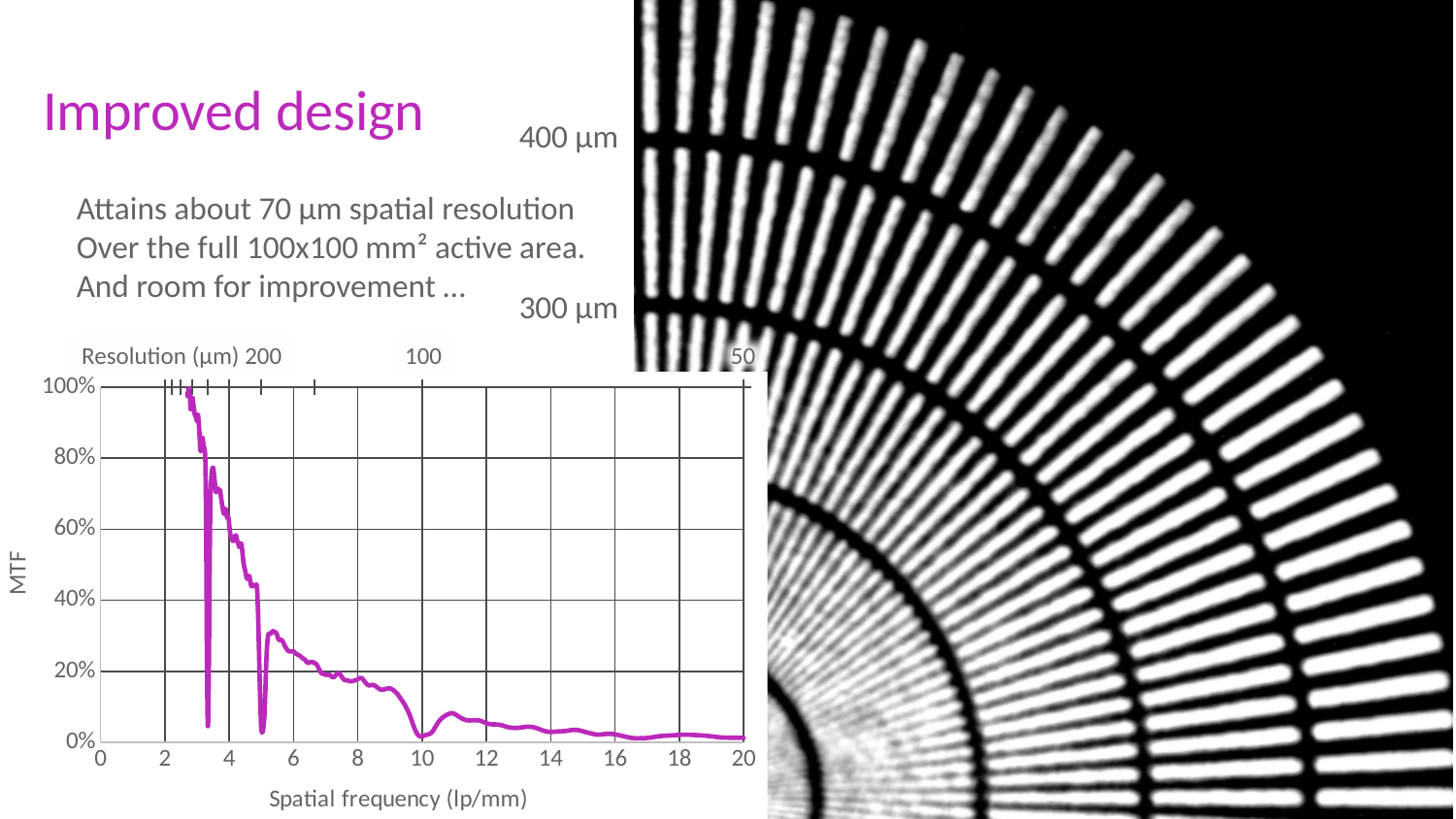
What is the label of the x axis of the chart? Spatial frequency (lp/mm) What is the highest value shown on the x axis of the chart? 20 Is the MTF value at a spatial frequency of 14 lp/mm greater or less than 20%? less Is the MTF value at a spatial frequency of 3 lp/mm greater or less than 60%? greater Is the MTF value at a spatial frequency of 6 lp/mm greater or less than 20%? greater Which is larger, the MTF value at 4 lp/mm or the MTF value at 8 lp/mm? 4 lp/mm What kind of chart is shown on the slide? line chart What is the label of the y axis of the chart? MTF Does the MTF value generally rise or fall as spatial frequency increases? fall